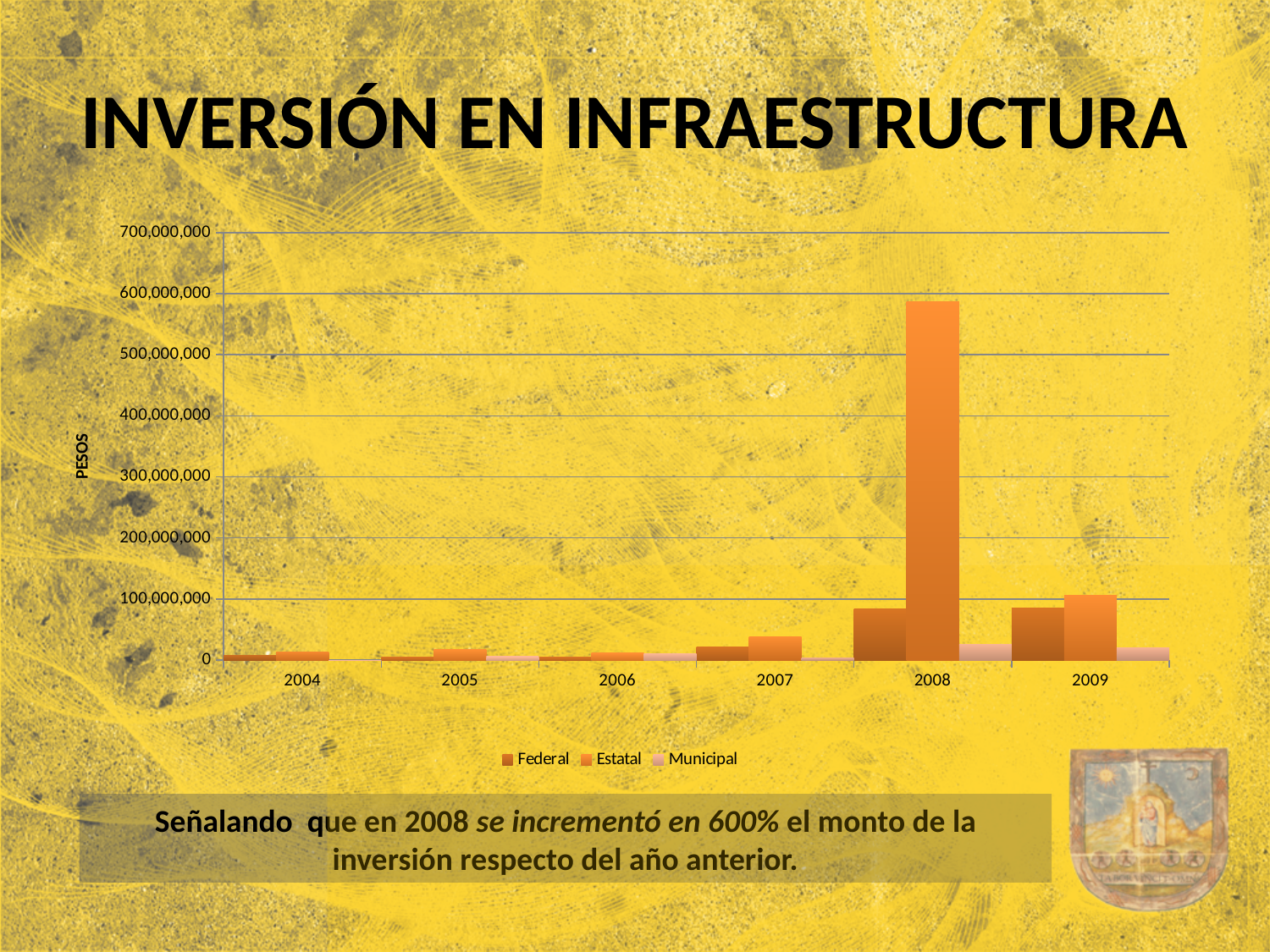
Which is larger, the Estatal value for 2008 or the Estatal value for 2009? Estatal 2008 In which year does the Estatal series reach its highest value? 2008 How many series does the chart legend list? 3 Does the Estatal series rise or fall from 2004 to 2008? rise Is the Estatal value for 2008 greater or less than 500,000,000? greater What label is shown on the vertical axis of the chart? PESOS Is the Federal value for 2008 greater or less than 100,000,000? less What kind of chart is shown on the slide? bar chart Which series has the highest value in 2008? Estatal Which series has the lowest value in 2008? Municipal What is the title of the chart on the slide? INVERSIÓN EN INFRAESTRUCTURA How many years are shown on the x axis of the chart? 6